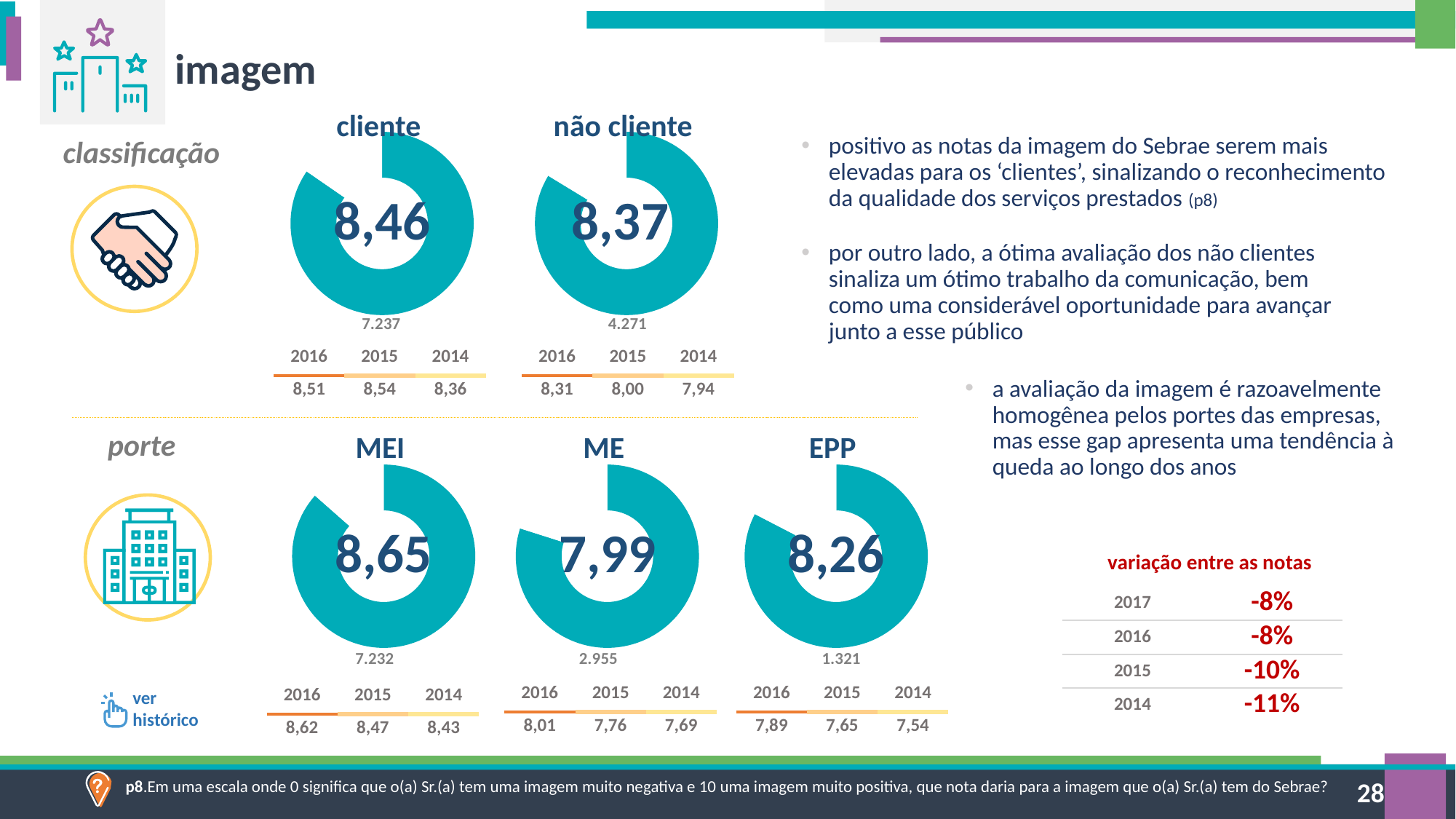
Which is larger, the 'cliente' donut chart value or the 'não cliente' donut chart value? cliente In the 'ME' donut chart, what value is shown in the centre? 7,99 What is the difference between the 'cliente' donut chart value and the 'não cliente' donut chart value? 0,09 Among the three 'porte' donut charts (MEI, ME, EPP), which has the lowest value? ME In the 'MEI' donut chart, what value is shown in the centre? 8,65 What kind of chart is used to display the 'cliente' value of 8,46? donut chart In the 'não cliente' donut chart, what value is shown in the centre? 8,37 In the 'EPP' donut chart, what value is shown in the centre? 8,26 Among the three 'porte' donut charts (MEI, ME, EPP), which has the highest value? MEI How many donut charts are shown in the 'porte' row of the slide? 3 Below the 'cliente' donut chart, what value is listed for 2015? 8,54 In the 'cliente' donut chart, what value is shown in the centre? 8,46